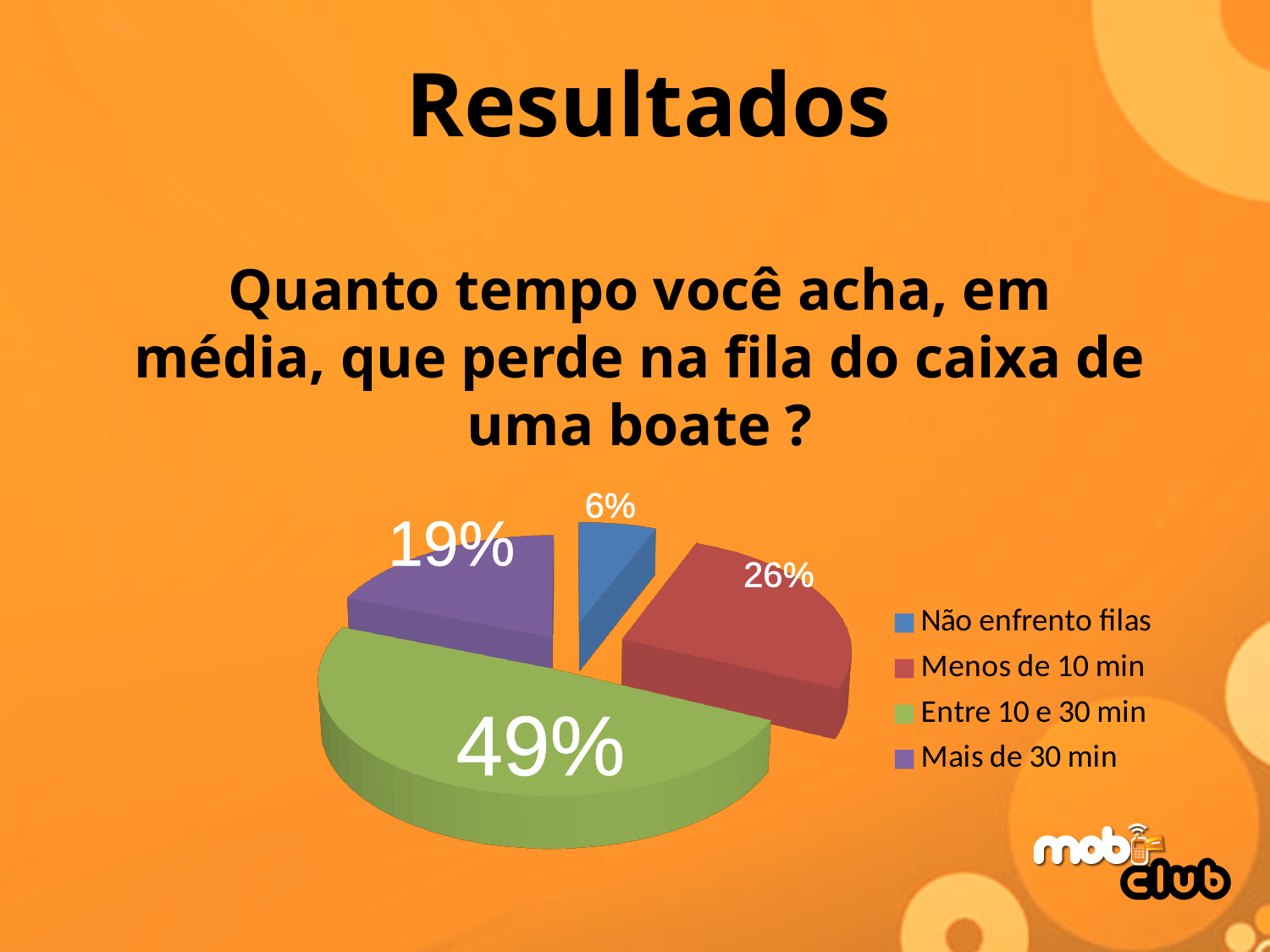
What percentage of respondents answered "Mais de 30 min"? 19% Which category has the largest share of the pie? Entre 10 e 30 min What percentage of respondents answered "Menos de 10 min"? 26% Which is larger: the share for "Menos de 10 min" or the share for "Mais de 30 min"? Menos de 10 min What question does the chart present results for? Quanto tempo você acha, em média, que perde na fila do caixa de uma boate ? Which category has the smallest share of the pie? Não enfrento filas How many categories does the pie chart have? 4 What kind of chart is shown on the slide? pie chart What is the difference in percentage points between "Entre 10 e 30 min" and "Menos de 10 min"? 23 What percentage of respondents answered "Não enfrento filas"? 6% What percentage of respondents answered "Entre 10 e 30 min"? 49% What colour is the slice for "Mais de 30 min"? purple